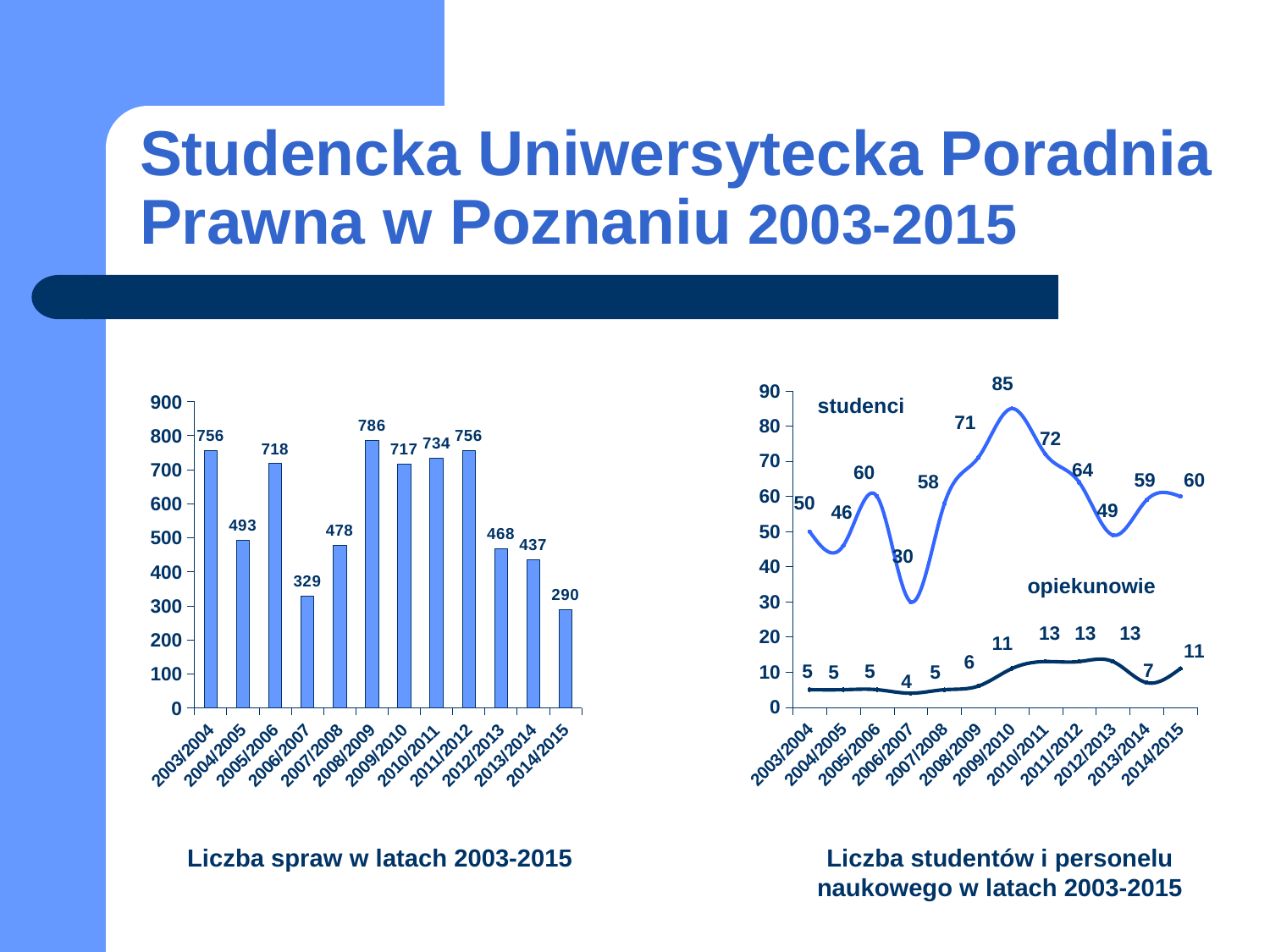
In the left chart (Liczba spraw w latach 2003-2015), what is the difference between the values for 2008/2009 and 2014/2015? 496 In the right chart (Liczba studentów i personelu naukowego), how many series are plotted? 2 What kind of chart is the left chart (Liczba spraw w latach 2003-2015)? bar chart In the left chart (Liczba spraw w latach 2003-2015), what is the value for 2006/2007? 329 In the right chart (Liczba studentów i personelu naukowego), what is the value for studenci in 2009/2010? 85 In the right chart (Liczba studentów i personelu naukowego), what is the value for opiekunowie in 2013/2014? 7 In the right chart (Liczba studentów i personelu naukowego), in which year is the studenci value lowest? 2006/2007 In the left chart (Liczba spraw w latach 2003-2015), which year has the highest value? 2008/2009 In the right chart (Liczba studentów i personelu naukowego), what is the difference between studenci and opiekunowie in 2014/2015? 49 In the left chart (Liczba spraw w latach 2003-2015), how many years are shown on the x axis? 12 In the right chart (Liczba studentów i personelu naukowego), is the studenci value for 2005/2006 larger or smaller than the value for 2004/2005? larger In the left chart (Liczba spraw w latach 2003-2015), which year has the lowest value? 2014/2015